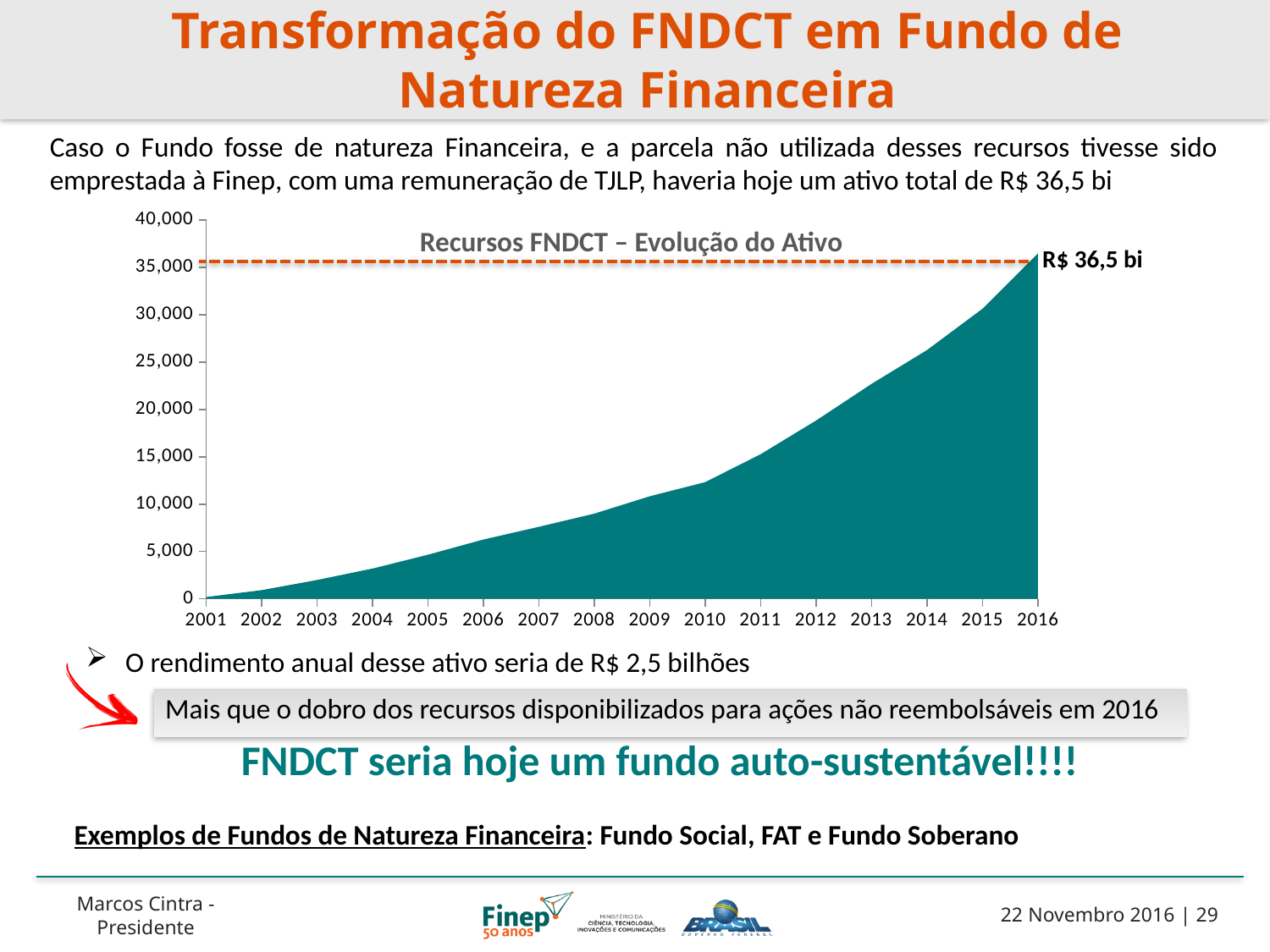
How many years are shown along the x axis of the chart? 16 Is the value for 2013 greater or less than 20,000? greater Which year has the larger value, 2008 or 2014? 2014 Is the value for 2015 greater or less than 30,000? greater What kind of chart is shown on the slide? Area chart Do the values rise or fall from 2001 to 2016? Rise Is the value for 2010 greater or less than 15,000? less What is the title of the chart? Recursos FNDCT – Evolução do Ativo Which year has the lowest value in the chart? 2001 Which year has the highest value in the chart? 2016 What value is labelled at the end of the series in 2016? R$ 36,5 bi